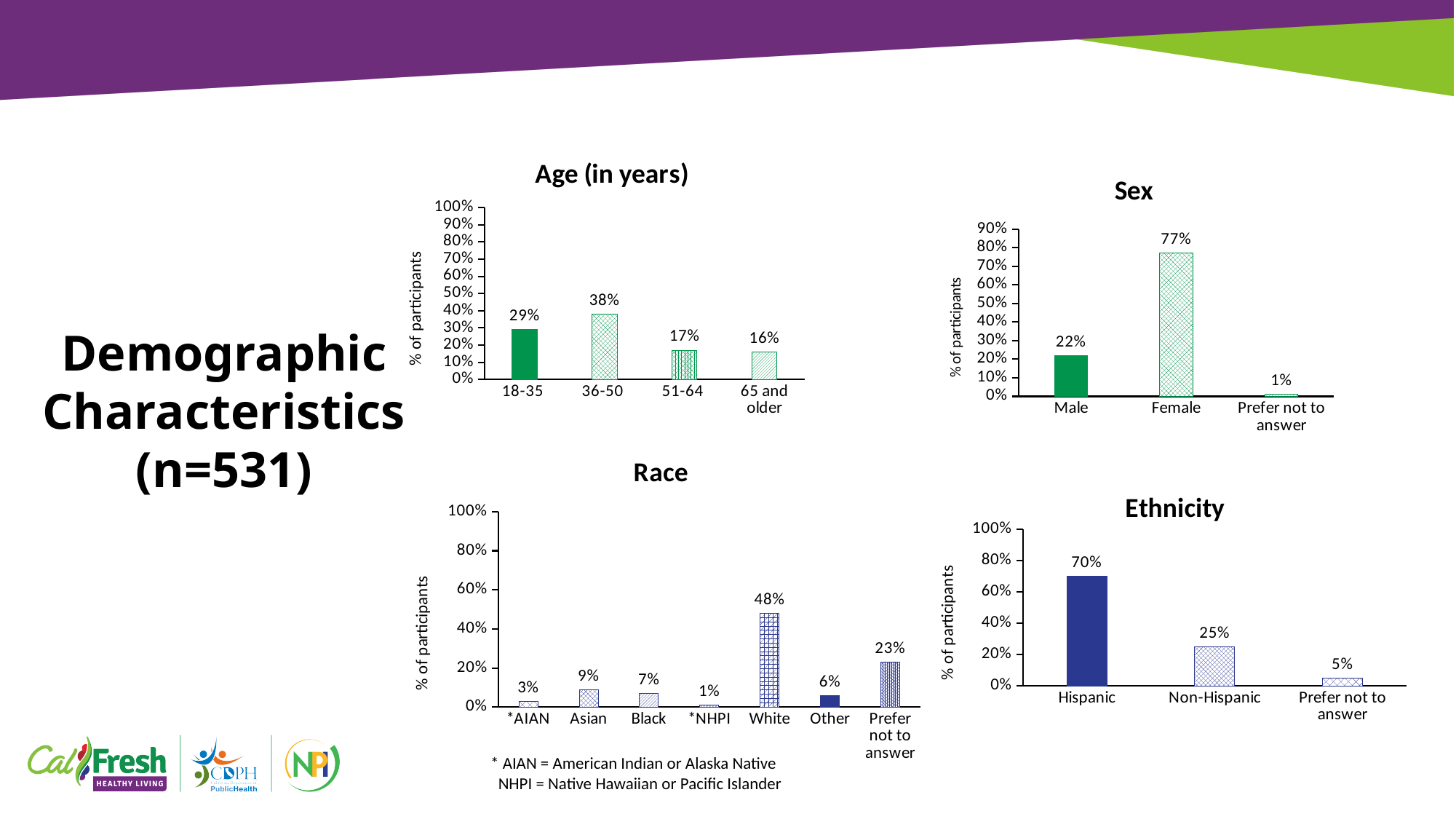
In the Sex chart, how many categories are shown? 3 In the Race chart, how many race categories are shown on the x axis? 7 In the Age (in years) chart, what percentage of participants are aged 36-50? 38% In the Race chart, what percentage of participants are Asian? 9% In the Sex chart, what percentage of participants are Female? 77% What kind of chart is the Ethnicity chart? Bar chart In the Race chart, which category has the highest percentage of participants? White In the Race chart, which is larger, Black or Other? Black In the Age (in years) chart, what is the difference between the 18-35 and 51-64 groups? 12% In the Age (in years) chart, which age group has the lowest percentage of participants? 65 and older In the Ethnicity chart, what percentage of participants are Non-Hispanic? 25% In the Sex chart, what is the difference between Female and Male? 55%